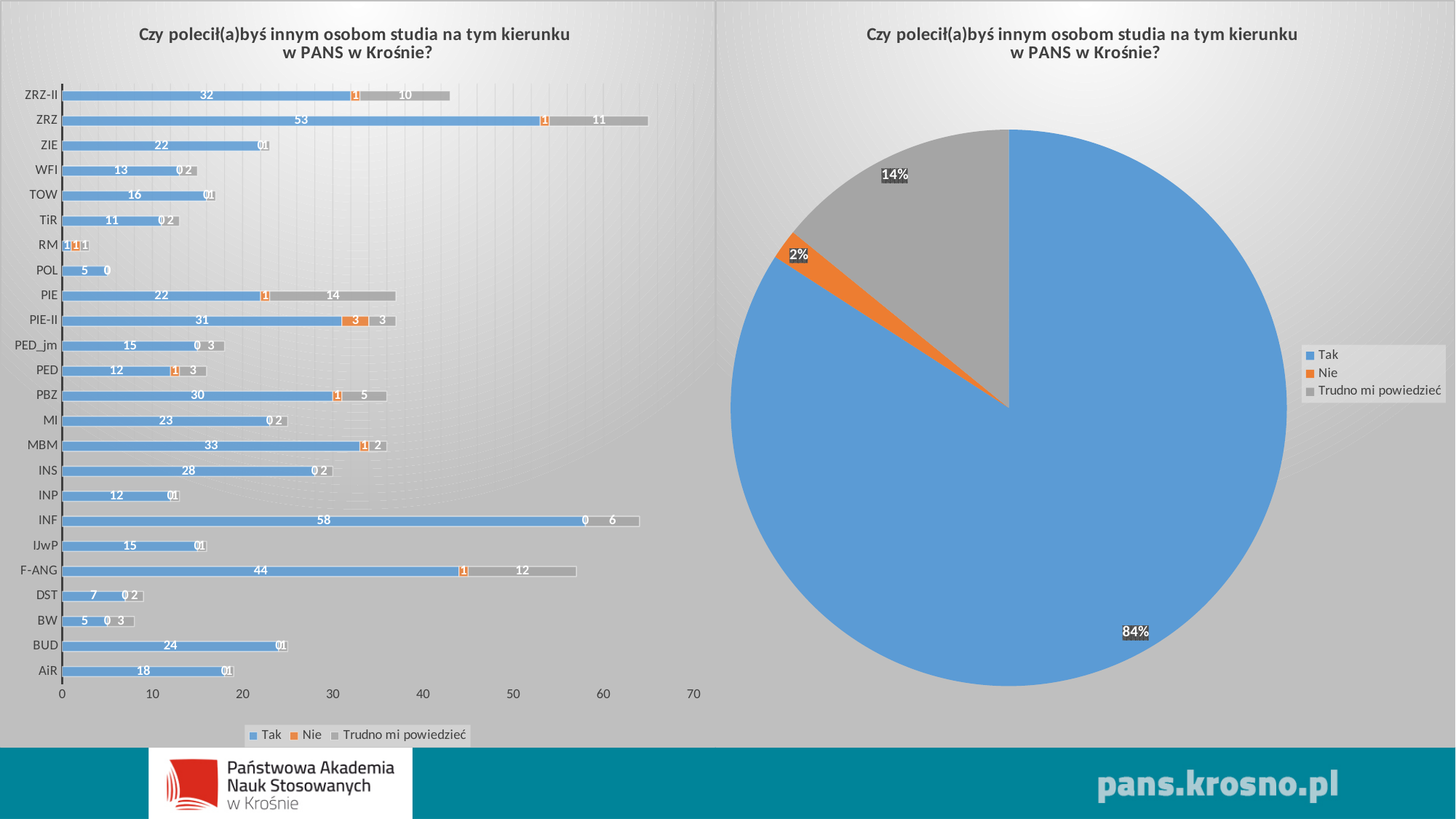
On the left bar chart, how many categories are shown on the vertical axis? 24 On the left bar chart, which category has the highest 'Tak' value? INF On the right pie chart, what share does 'Tak' have? 84% On the right pie chart, what share does 'Trudno mi powiedzieć' have? 14% On the left bar chart, which category has the lowest 'Tak' value? RM On the left bar chart, how many series does the legend list? 3 On the left bar chart, what is the difference between the 'Tak' values for ZRZ and ZRZ-II? 21 On the left bar chart, what is the total of the stacked bar for ZRZ? 65 On the left bar chart, what is the 'Tak' value for INF? 58 On the left bar chart, what is the 'Trudno mi powiedzieć' value for F-ANG? 12 On the left bar chart, which has a larger 'Tak' value, MBM or PBZ? MBM What kind of chart is on the right side of the slide? Pie chart